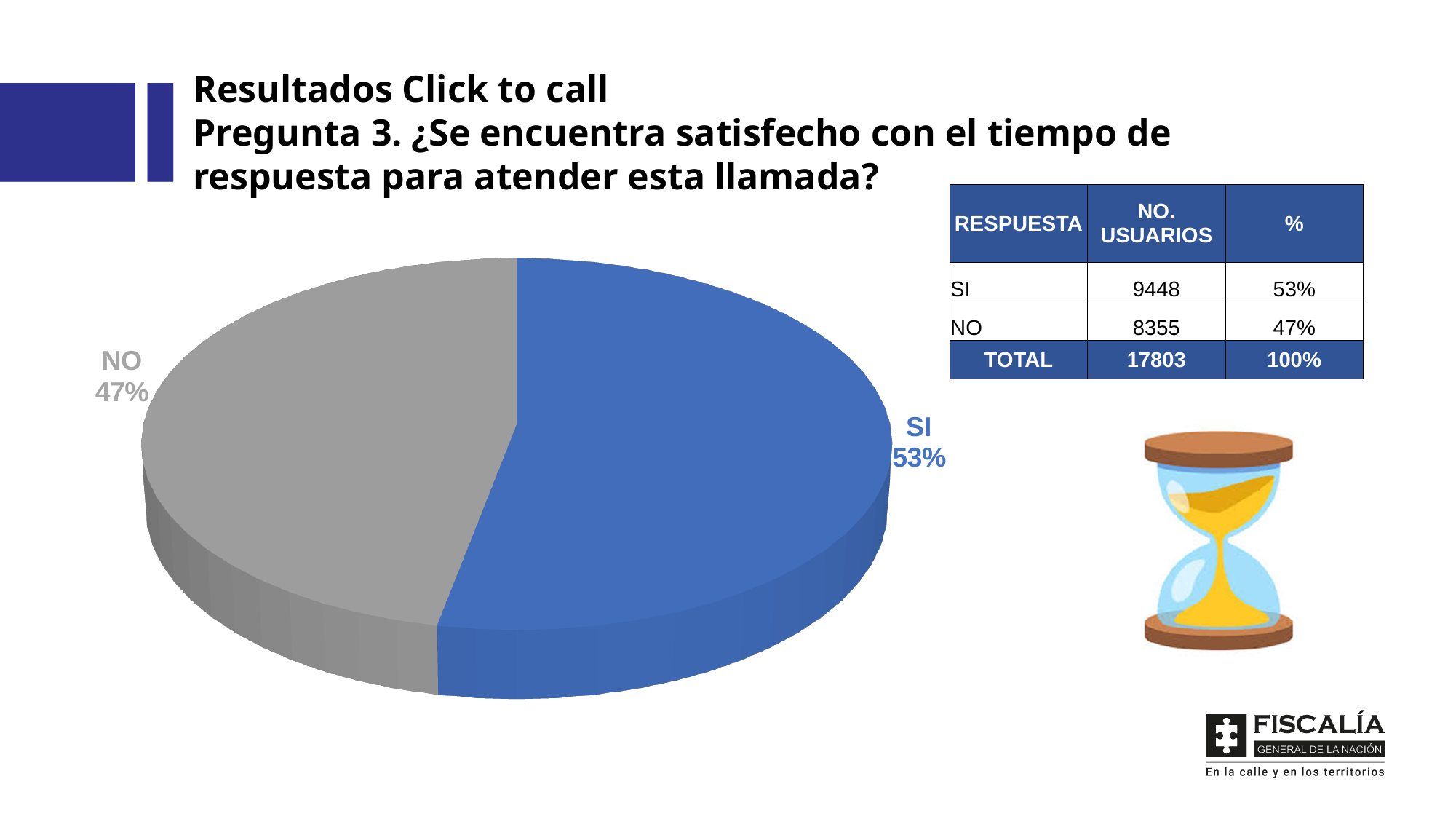
What colour is the SI slice of the pie chart? Blue Which is larger, the SI slice or the NO slice? SI What is the difference in percentage points between the SI and NO slices? 6% What kind of chart is shown on the slide? Pie chart How many slices does the pie chart have? 2 What share of the pie does the NO slice represent? 47% Which slice of the pie is the smallest? NO Which slice of the pie is the largest? SI What share of the pie does the SI slice represent? 53% Is the share for SI greater or less than 50%? greater What colour is the NO slice of the pie chart? Grey